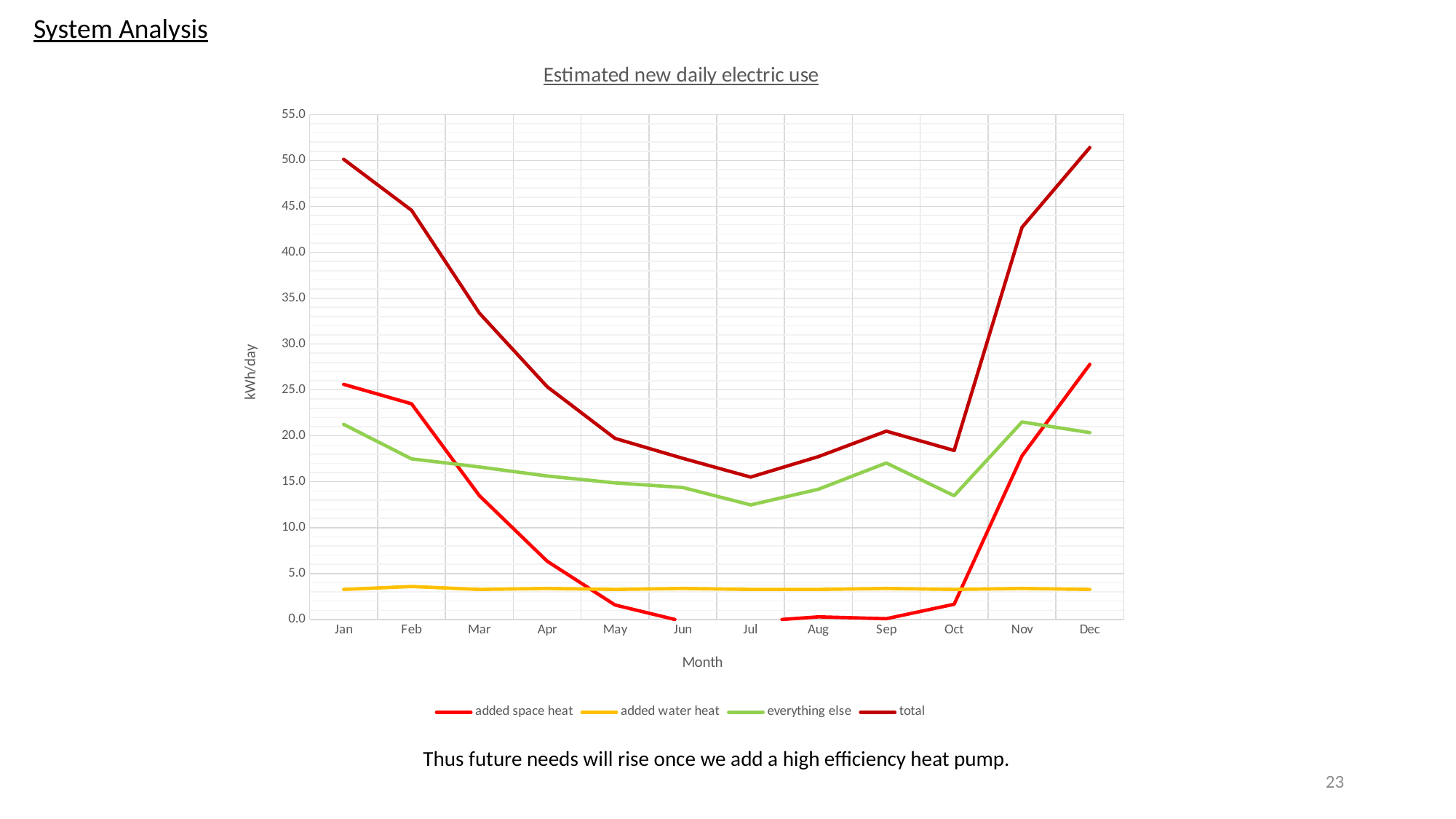
What kind of chart is shown on the slide? line chart In which month is the total series at its lowest? Jul Is the value for total in Jul greater or less than 20.0? less How many series does the legend list? 4 Is the value for everything else in Jan greater or less than 20.0? greater In Nov, which is larger: added space heat or everything else? everything else Is the value for added space heat in Dec greater or less than 25.0? greater In Jan, which is larger: added space heat or everything else? added space heat How many months are plotted along the x axis? 12 Does the total series rise or fall from Jan to Jul? fall What is the label on the y axis? kWh/day